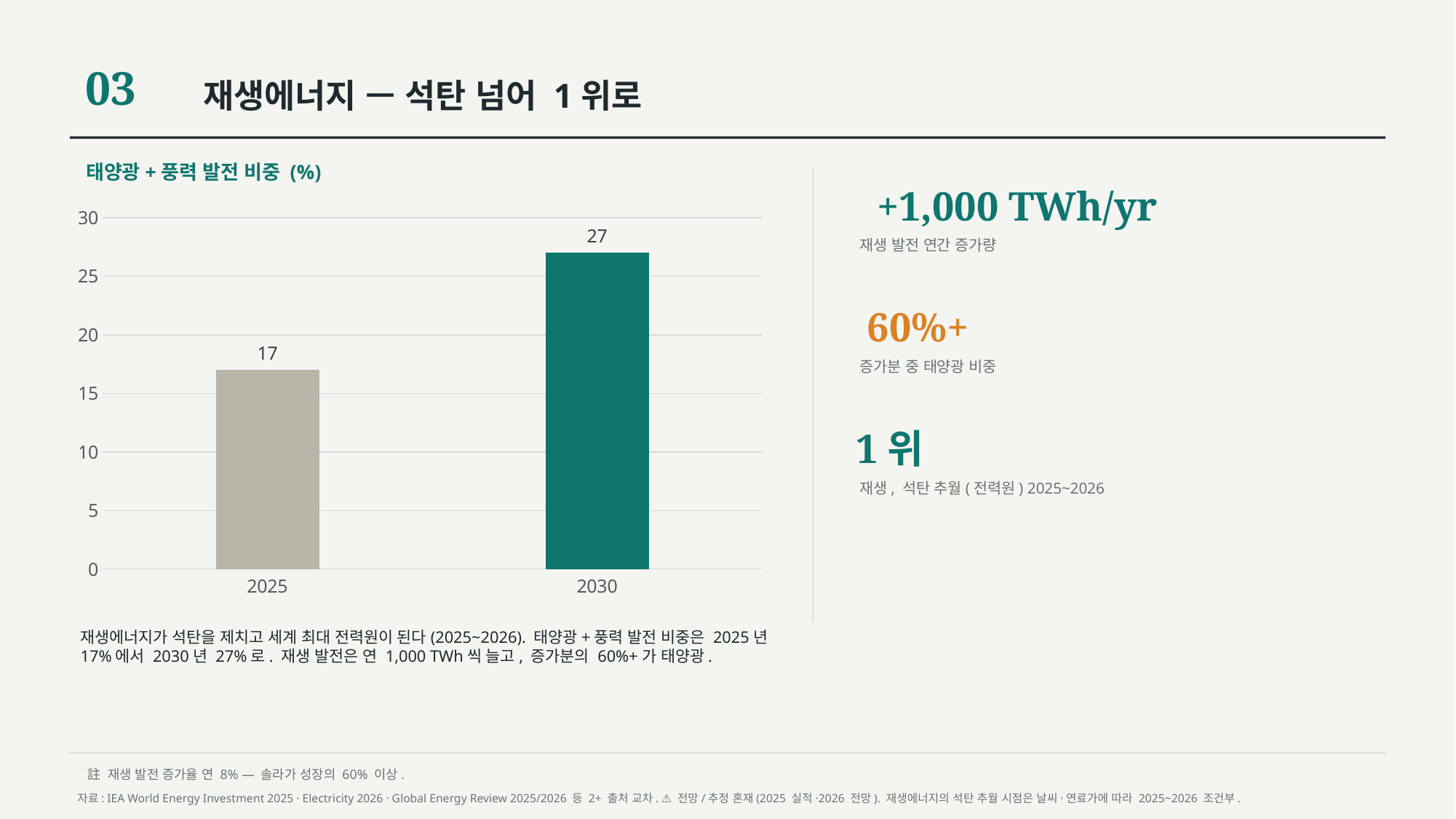
Is the value for 2030 greater or less than 25? greater Is the value for 2025 larger or smaller than the value for 2030? smaller What is the value for 2025 in the chart? 17 Do the values rise or fall from 2025 to 2030? rise Is the value for 2025 greater or less than 20? less What is the difference between the 2030 value and the 2025 value? 10 Which year has the lower value in the chart? 2025 What is the title of the chart? 태양광 + 풍력 발전 비중 (%) What is the value for 2030 in the chart? 27 Which year has the higher value in the chart? 2030 What kind of chart is shown on the slide? bar chart How many bars are shown in the chart? 2